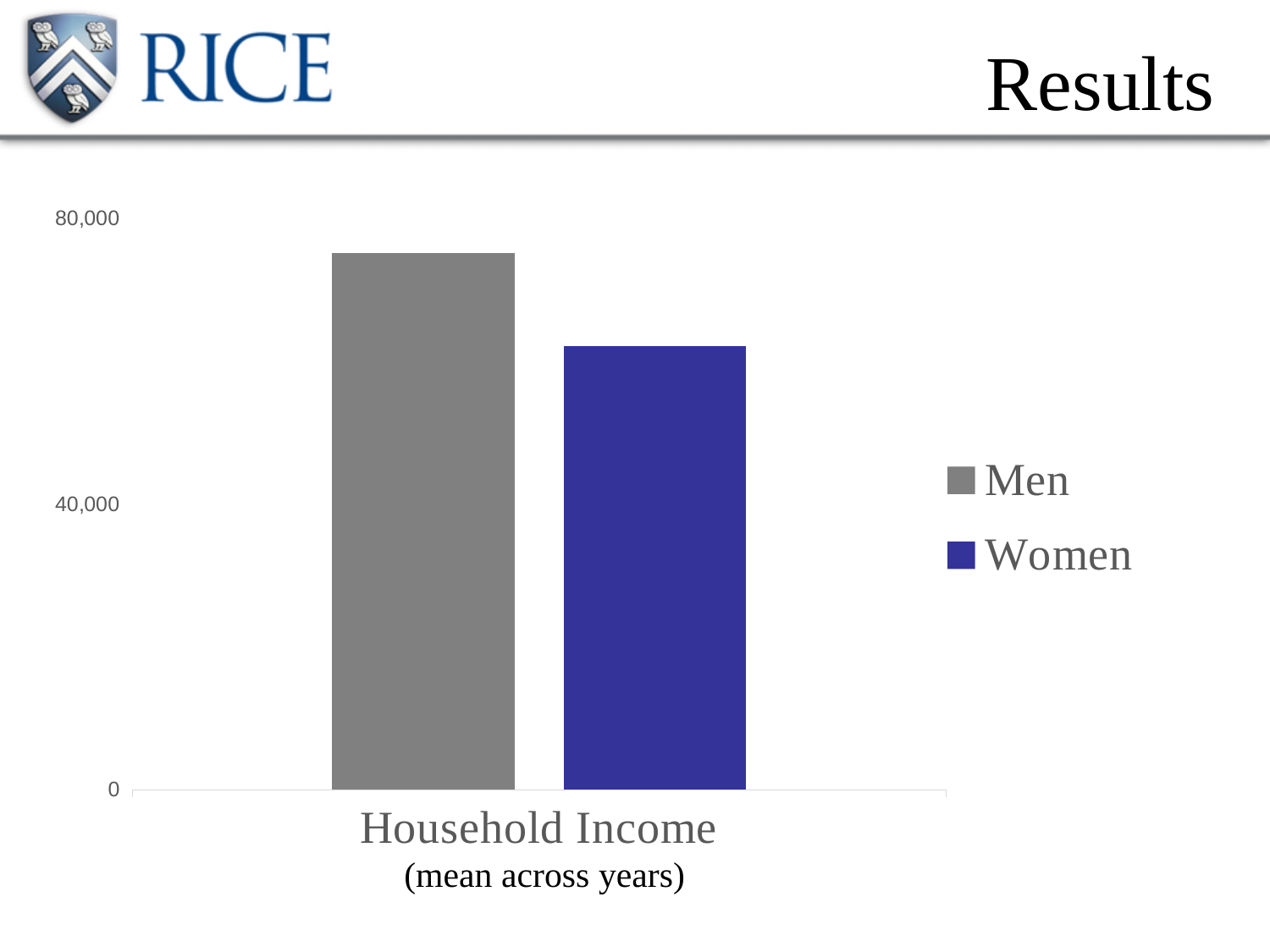
Is the household income value for Women greater or less than 80,000? less How many categories are plotted on the x axis? 1 Is the household income value for Women greater or less than 40,000? greater Which series has the higher household income bar, Men or Women? Men What kind of chart is shown on the slide? bar chart Is the household income value for Men greater or less than 80,000? less Which series has the highest household income bar? Men Which series has the lowest household income bar? Women Which series are listed in the legend? Men, Women How many series does the legend list? 2 What colour is the bar for Women? blue